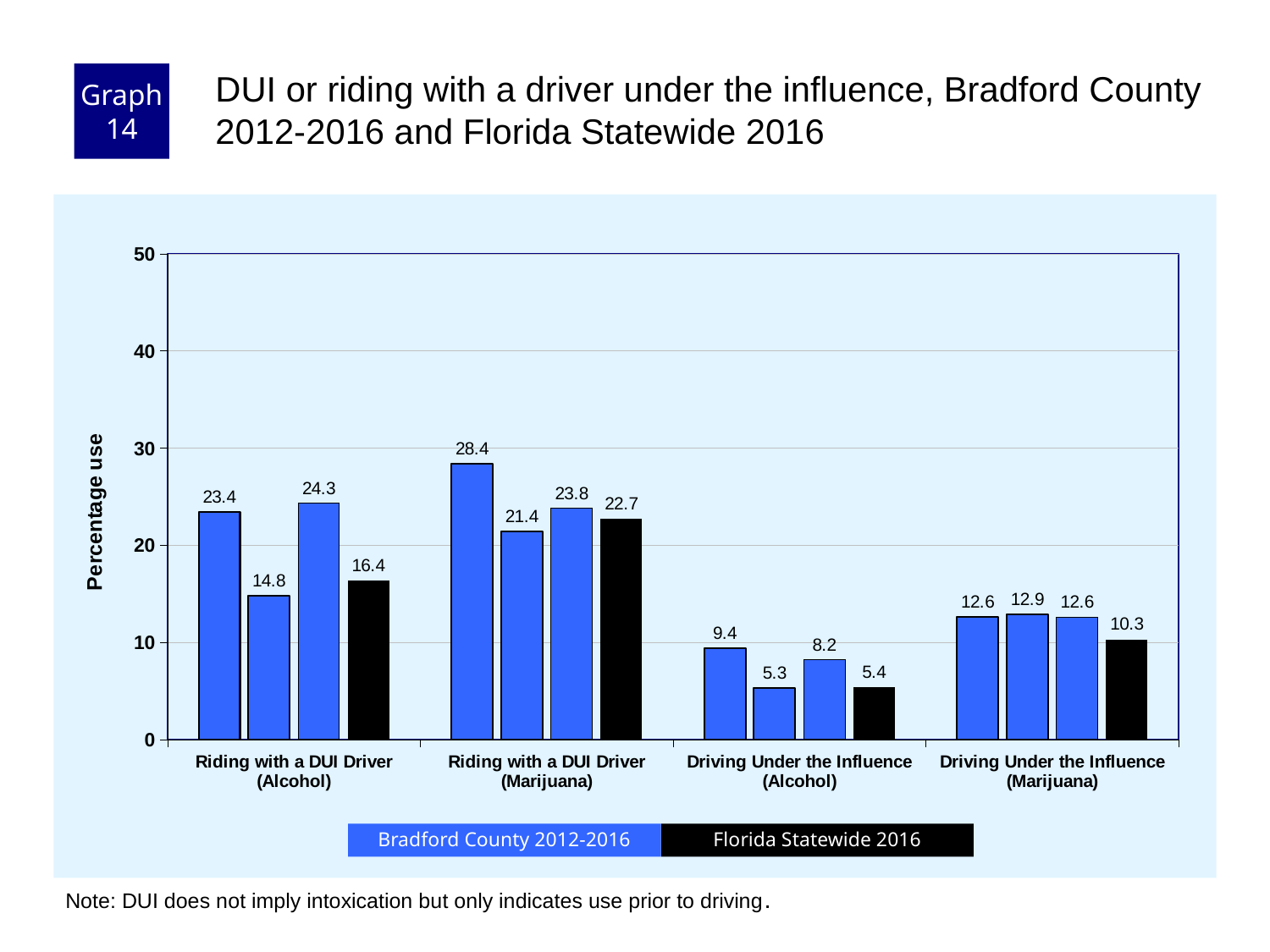
How many series does the legend list? 2 Is the Florida Statewide 2016 value for Riding with a DUI Driver (Marijuana) greater or less than 20? greater What is the difference between the Florida Statewide 2016 values for Riding with a DUI Driver (Marijuana) and Riding with a DUI Driver (Alcohol)? 6.3 How many categories are shown on the x axis? 4 What is the Florida Statewide 2016 value for Riding with a DUI Driver (Alcohol)? 16.4 Which bar on the chart has the highest value? The first Bradford County bar for Riding with a DUI Driver (Marijuana), 28.4 What is the Florida Statewide 2016 value for Driving Under the Influence (Marijuana)? 10.3 Which is larger: the Florida Statewide 2016 value for Driving Under the Influence (Alcohol) or for Driving Under the Influence (Marijuana)? Driving Under the Influence (Marijuana) What is the value of the second Bradford County bar for Driving Under the Influence (Alcohol)? 5.3 Which bar on the chart has the lowest value? The second Bradford County bar for Driving Under the Influence (Alcohol), 5.3 What type of chart is shown on the slide? Bar chart What is the value of the first Bradford County bar for Riding with a DUI Driver (Marijuana)? 28.4